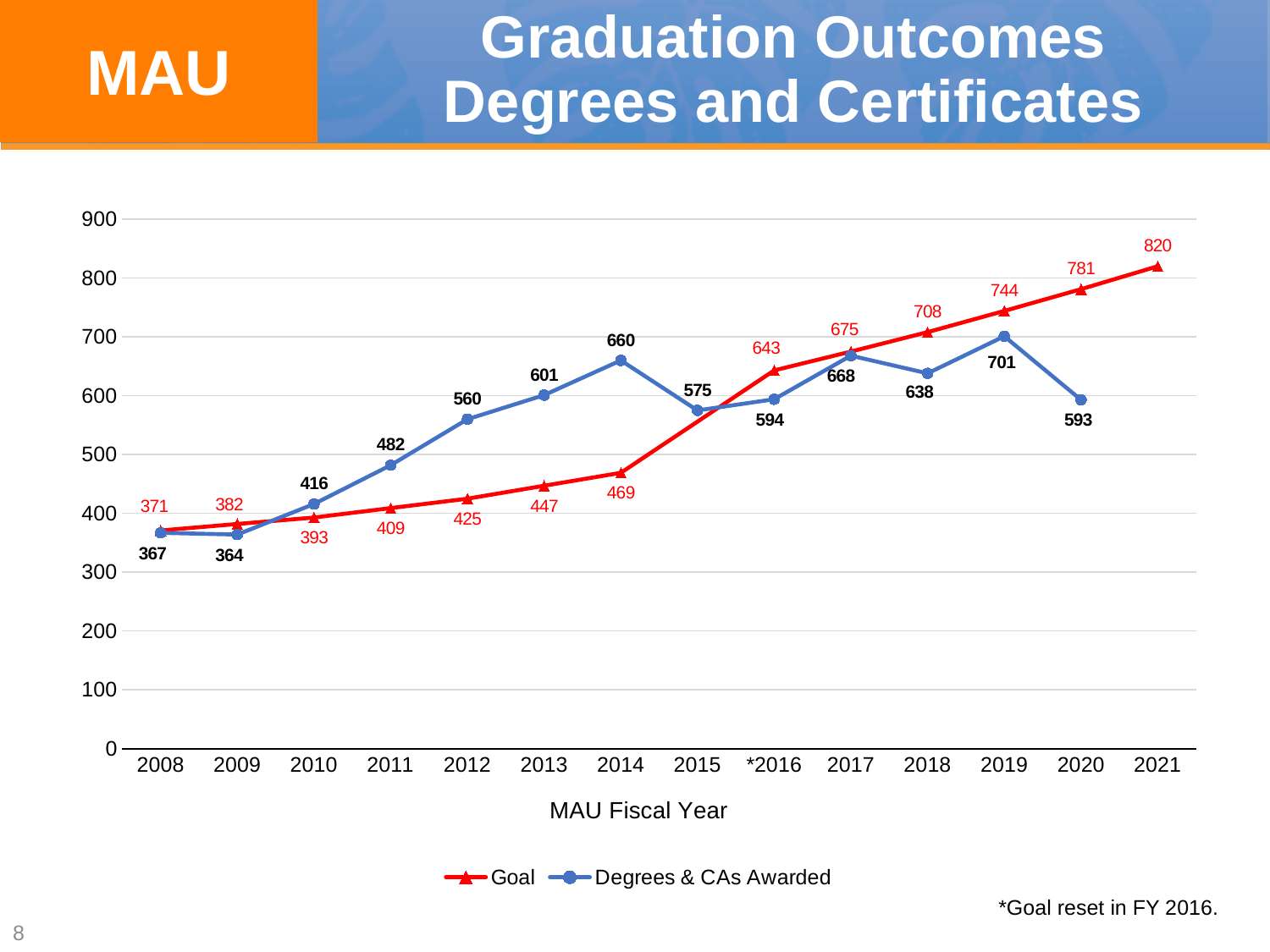
In which fiscal year is the Degrees & CAs Awarded value highest? 2019 What kind of chart is shown on the slide? Line chart What is the difference between the Goal and Degrees & CAs Awarded in 2019? 43 What is the difference between the Goal and Degrees & CAs Awarded in 2020? 188 What is the Goal value for 2021? 820 In which fiscal year is the Degrees & CAs Awarded value lowest? 2009 What is the value of Degrees & CAs Awarded in 2014? 660 How many fiscal years are shown on the x axis? 14 In 2014, which is larger: the Goal or Degrees & CAs Awarded? Degrees & CAs Awarded What is the value of Degrees & CAs Awarded in *2016? 594 How many series does the legend list? 2 Does the Goal series rise or fall from 2008 to 2021? Rises